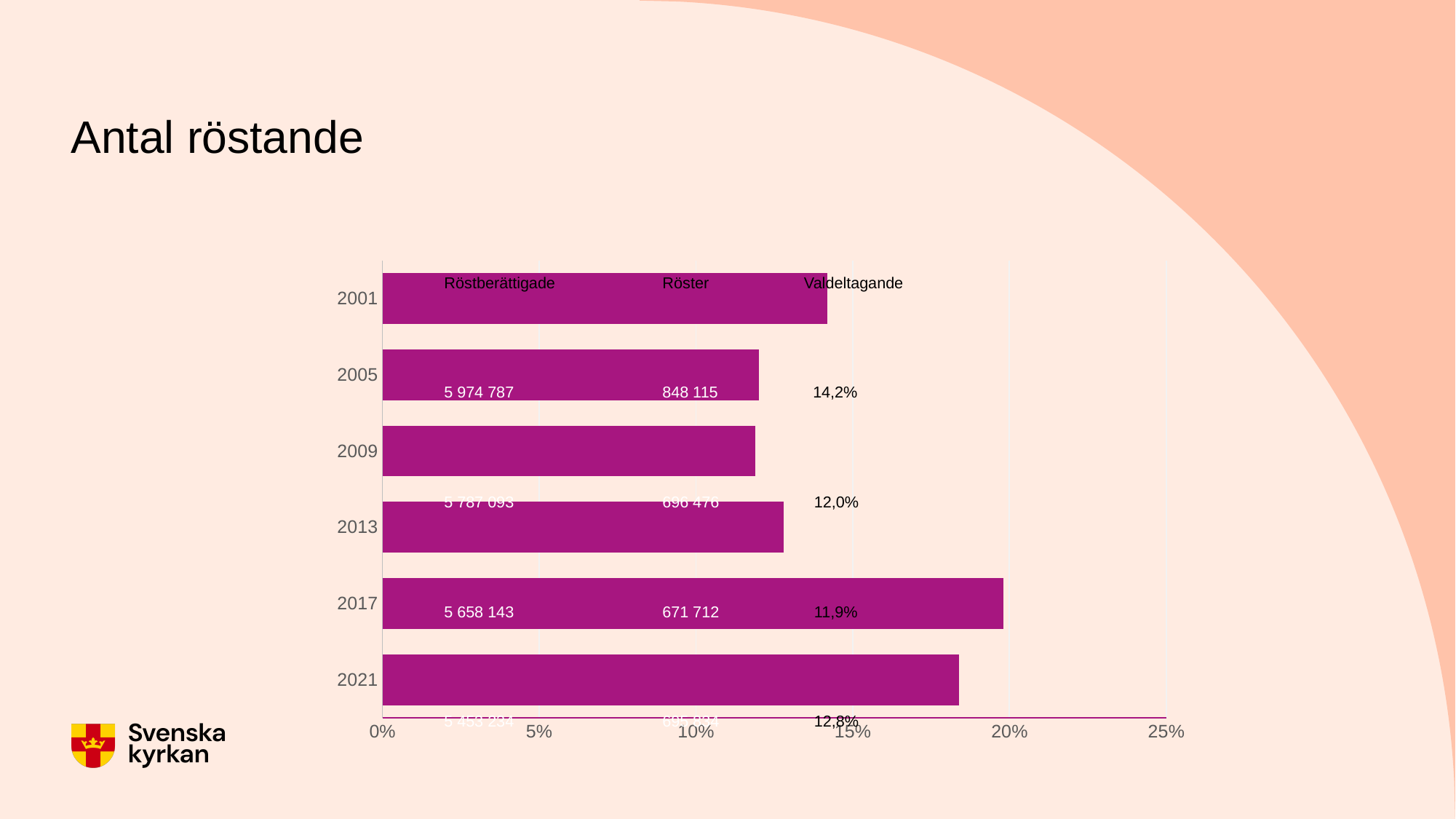
Which year has the longest bar on the chart? 2017 Is the bar for 2017 longer or shorter than the bar for 2021? longer Is the value for 2013 greater or less than 15%? less How many years are shown as categories on the chart? 6 Is the value for 2017 greater or less than 15%? greater Is the value for 2009 greater or less than 10%? greater Which bar is longer, 2001 or 2005? 2001 What is the highest value shown on the horizontal axis of the chart? 25% What kind of chart is shown on the slide? bar chart What is the title of the slide with the chart? Antal röstande